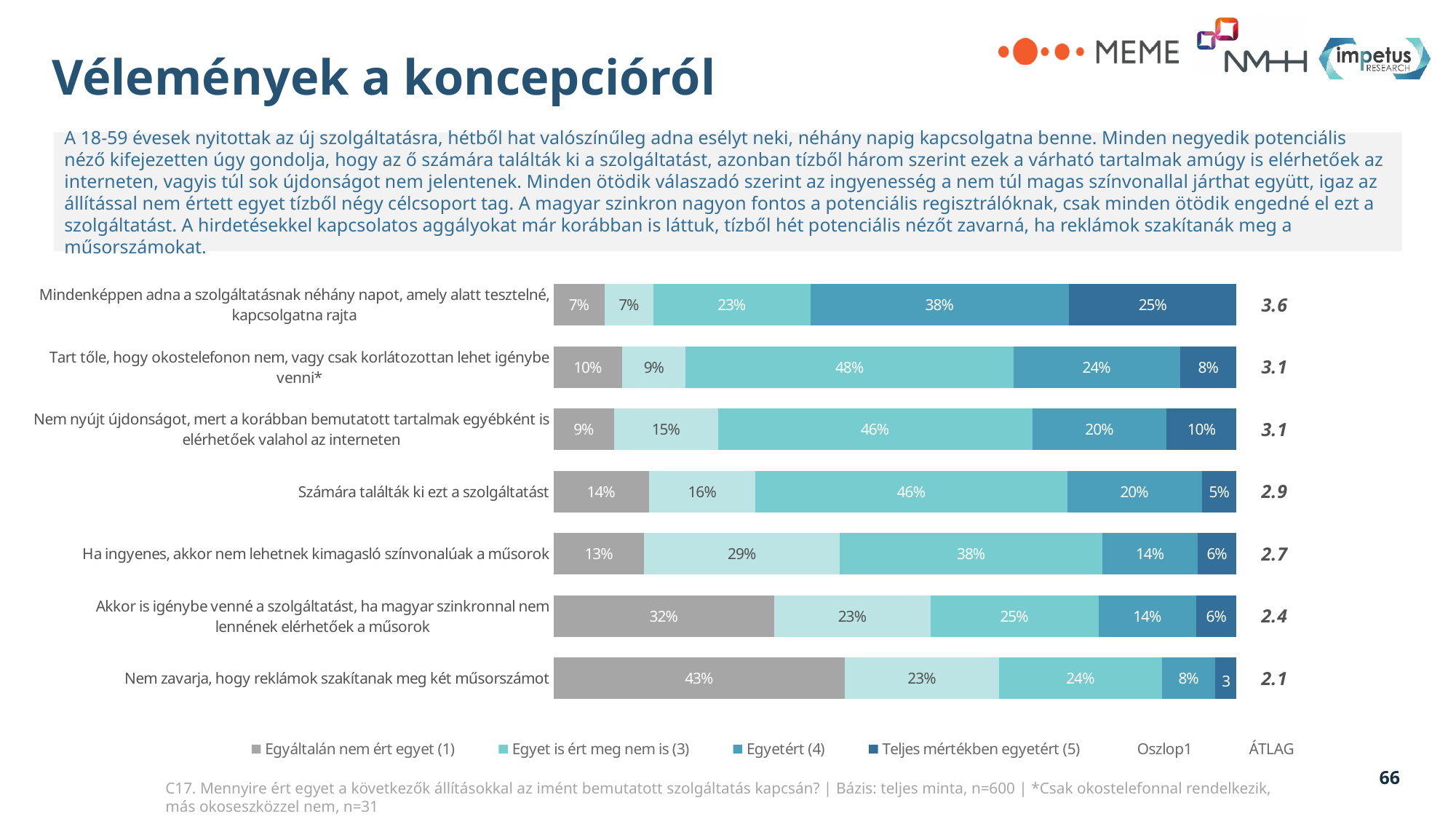
What percentage of respondents fully agree (Teljes mértékben egyetért (5)) with the statement "Mindenképpen adna a szolgáltatásnak néhány napot, amely alatt tesztelné, kapcsolgatna rajta"? 25% Which statement has the lowest average (ÁTLAG) value? Nem zavarja, hogy reklámok szakítanak meg két műsorszámot (2.1) What is the difference in the "Egyáltalán nem ért egyet (1)" share between "Nem zavarja, hogy reklámok szakítanak meg két műsorszámot" and "Akkor is igénybe venné a szolgáltatást, ha magyar szinkronnal nem lennének elérhetőek a műsorok"? 11 percentage points What percentage of respondents chose "Egyet is ért meg nem is (3)" for the statement "Tart tőle, hogy okostelefonon nem, vagy csak korlátozottan lehet igénybe venni"? 48% What percentage of respondents chose "Egyáltalán nem ért egyet (1)" for the statement "Nem zavarja, hogy reklámok szakítanak meg két műsorszámot"? 43% Which statement has a larger "Egyetért (4)" share: "Mindenképpen adna a szolgáltatásnak néhány napot..." or "Tart tőle, hogy okostelefonon nem, vagy csak korlátozottan lehet igénybe venni"? Mindenképpen adna a szolgáltatásnak néhány napot... (38%) Which statement has the highest average (ÁTLAG) value? Mindenképpen adna a szolgáltatásnak néhány napot, amely alatt tesztelné, kapcsolgatna rajta (3.6) How many statements are shown in the chart? 7 What kind of chart is shown on the slide? Stacked horizontal bar chart What is the average (ÁTLAG) value for the statement "Számára találták ki ezt a szolgáltatást"? 2.9 What is the total of the segments in the bar for "Ha ingyenes, akkor nem lehetnek kimagasló színvonalúak a műsorok"? 100% What is the title of the slide? Vélemények a koncepcióról